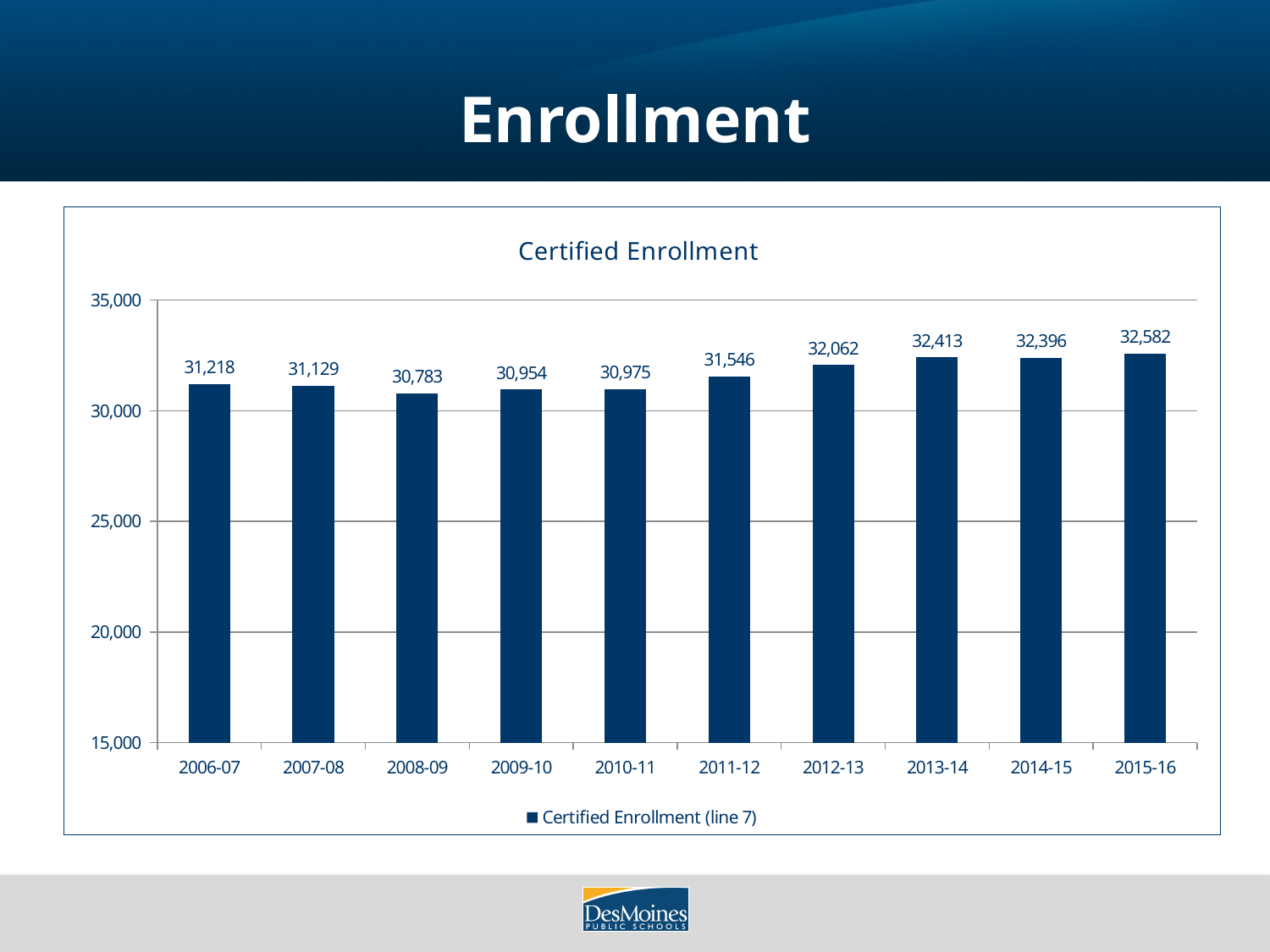
What is the difference in certified enrollment between 2013-14 and 2012-13? 351 What is the title of the chart? Certified Enrollment What kind of chart is shown on the slide? Bar chart Which year has the larger certified enrollment, 2009-10 or 2011-12? 2011-12 What is the certified enrollment for 2006-07? 31,218 How many series does the legend list? 1 What is the certified enrollment for 2012-13? 32,062 What is the difference in certified enrollment between 2015-16 and 2006-07? 1,364 What is the certified enrollment for 2015-16? 32,582 Which school year has the highest certified enrollment? 2015-16 How many school years are shown on the chart? 10 Which school year has the lowest certified enrollment? 2008-09